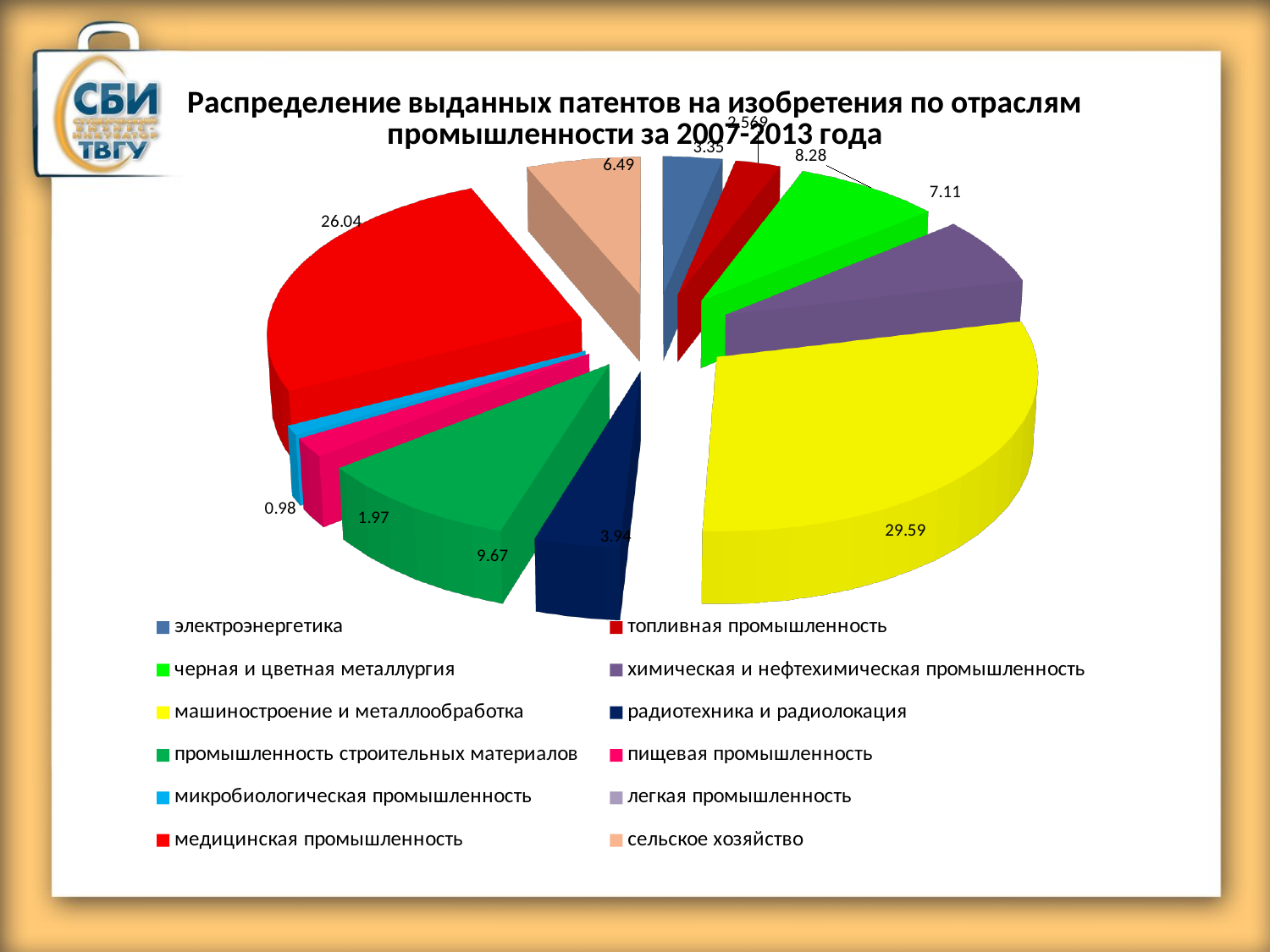
What value is shown for промышленность строительных материалов? 9.67 What value is shown for машиностроение и металлообработка? 29.59 Which industry has the largest slice of the pie? машиностроение и металлообработка What is the difference between the values for машиностроение и металлообработка and медицинская промышленность? 3.55 What value is shown for черная и цветная металлургия? 8.28 What value is shown for сельское хозяйство? 6.49 Which is larger, the value for медицинская промышленность or for машиностроение и металлообработка? машиностроение и металлообработка What kind of chart is shown on the slide? Pie chart What value is shown for медицинская промышленность? 26.04 How many categories does the legend list? 12 What colour is the slice for машиностроение и металлообработка? Yellow What value is shown for радиотехника и радиолокация? 3.94